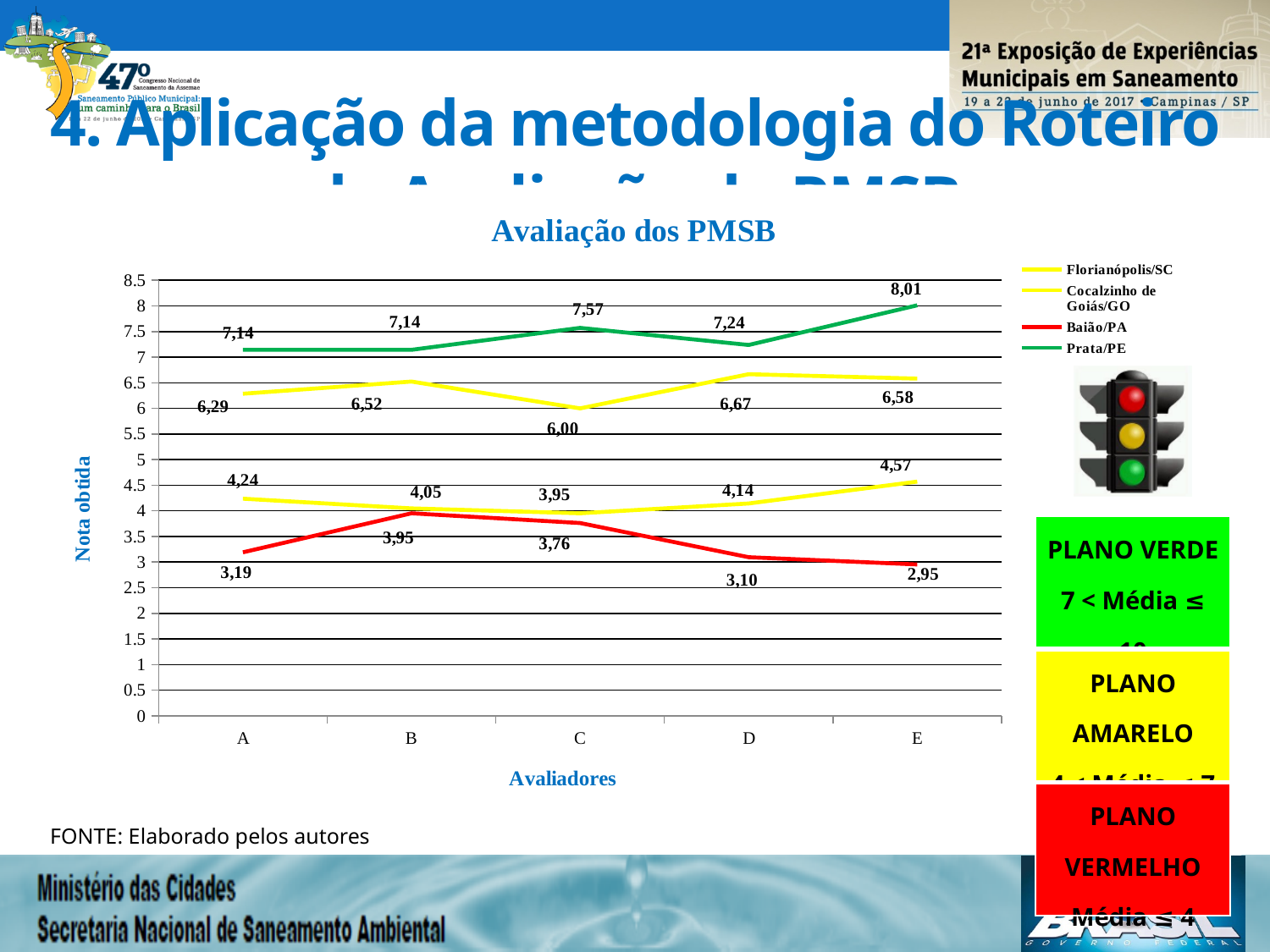
Does the Baião/PA line rise or fall from evaluator B to evaluator E? Fall What value does Prata/PE receive from evaluator E? 8,01 How many series does the legend list? 4 What kind of chart is shown? Line chart What value does Baião/PA receive from evaluator E? 2,95 What value does Prata/PE receive from evaluator C? 7,57 How many evaluators are shown on the x axis? 5 For Baião/PA, which is larger: the score from evaluator B or from evaluator D? Evaluator B What value does Baião/PA receive from evaluator A? 3,19 Which evaluator gives Baião/PA its lowest score? E What is the difference between Prata/PE's score from evaluator E and from evaluator A? 0,87 Which evaluator gives Prata/PE its highest score? E